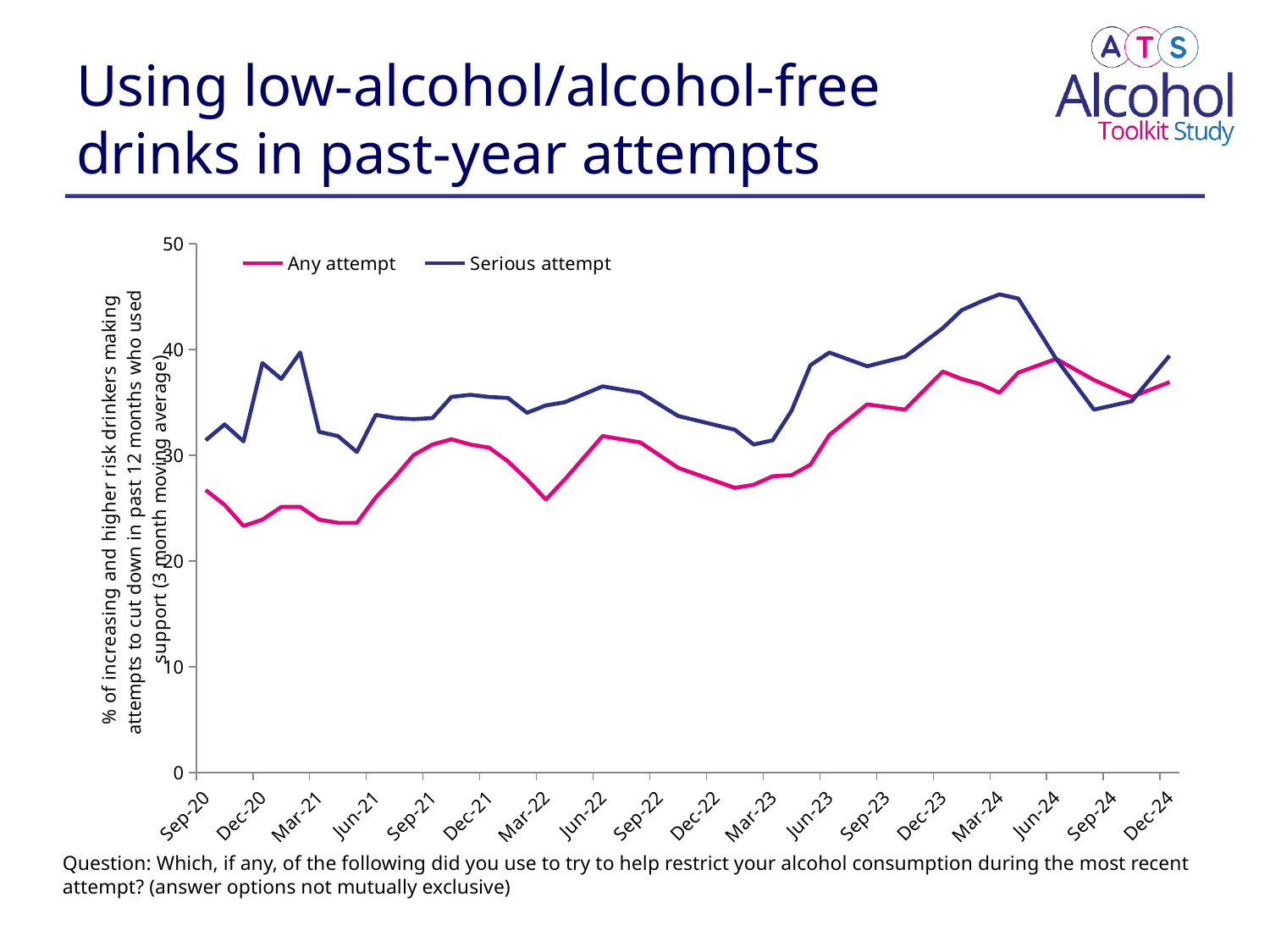
Which series is drawn in pink? Any attempt What are the two series named in the legend? Any attempt and Serious attempt Is the value for Any attempt at Mar-22 greater or less than 30? less How many date labels are shown on the x axis? 18 How many series does the legend list? 2 Is the value for Any attempt at Sep-20 greater or less than 30? less Is the value for Serious attempt at Mar-24 greater or less than 40? greater At which labelled date does the Serious attempt series reach its highest value? Mar-24 Does the Serious attempt series rise or fall between Mar-24 and Sep-24? fall At Mar-24, which series has the higher value, Any attempt or Serious attempt? Serious attempt What kind of chart is shown on the slide? line chart